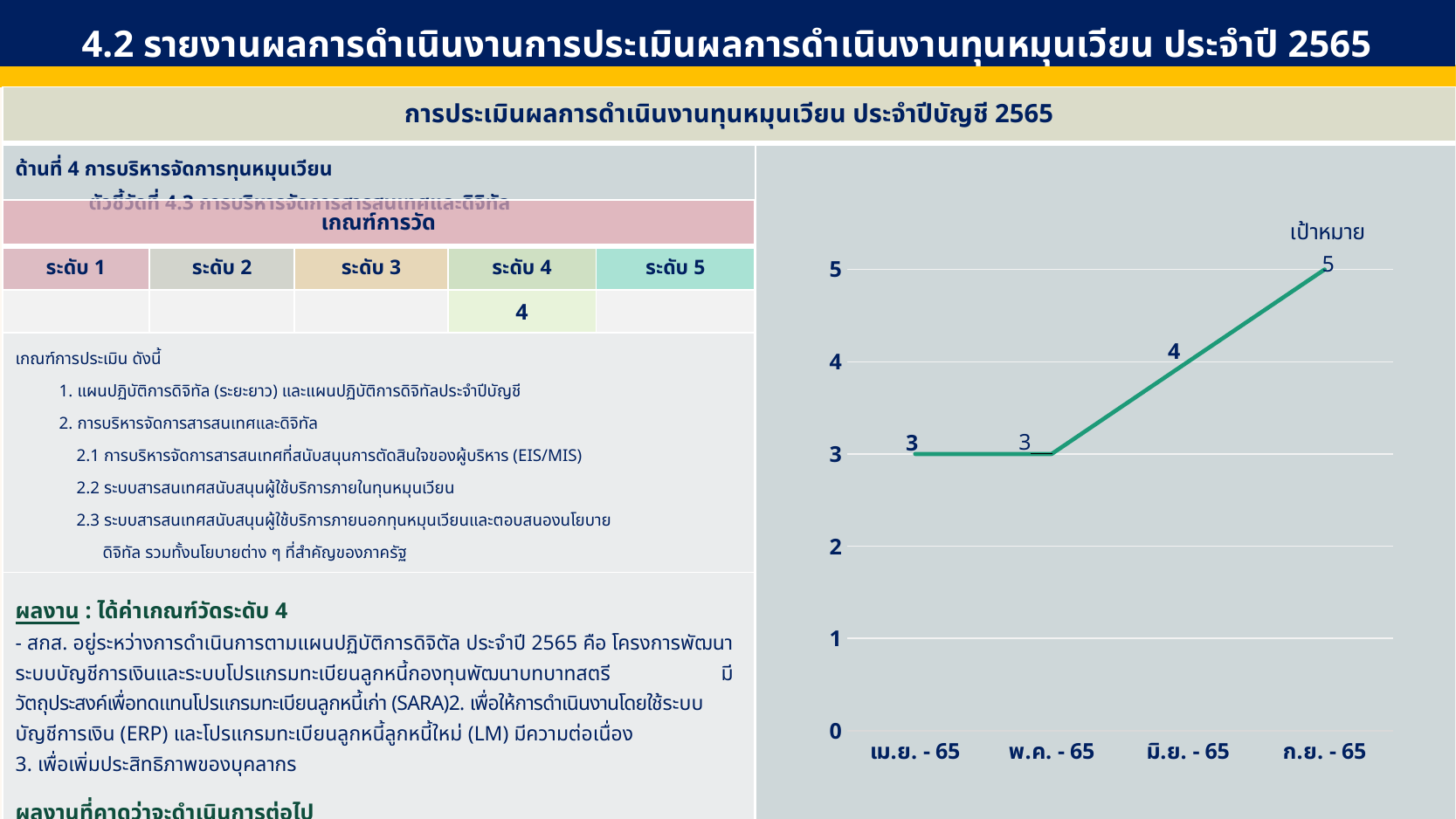
What is the value plotted for ก.ย. - 65? 5 What label appears above the last data point of the line chart? เป้าหมาย What is the value plotted for พ.ค. - 65? 3 What is the difference between the values for ก.ย. - 65 and เม.ย. - 65? 2 What kind of chart is shown on the right side of the slide? line chart How many data points are plotted on the line chart? 4 Which month on the x axis has the highest value? ก.ย. - 65 Which is larger, the value for มิ.ย. - 65 or the value for พ.ค. - 65? มิ.ย. - 65 What is the highest tick value shown on the y axis of the line chart? 5 What is the value plotted for มิ.ย. - 65? 4 Do the values rise or fall from เม.ย. - 65 to ก.ย. - 65? rise What is the value plotted for เม.ย. - 65? 3